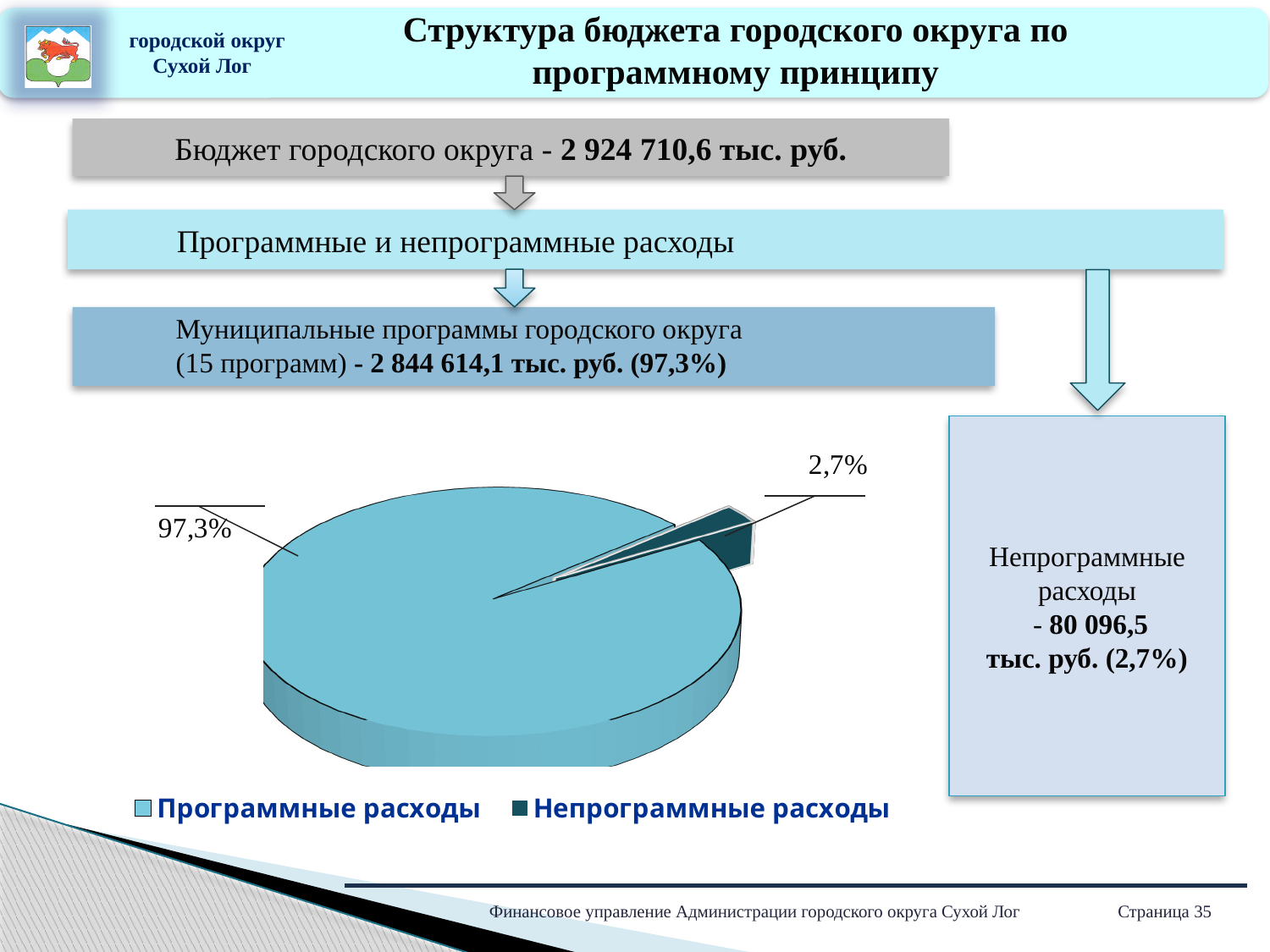
How many slices does the pie chart have? 2 How many entries does the legend of the pie chart list? 2 What share of the pie does Непрограммные расходы take? 2,7% Which slice of the pie chart is the smallest? Непрограммные расходы What kind of chart is shown on the slide? pie chart Which legend entry is shown in the dark teal colour? Непрограммные расходы What is the difference in percentage points between the Программные расходы and Непрограммные расходы slices? 94,6 Which legend entry is shown in the light blue colour? Программные расходы Which is larger in the pie chart: Программные расходы or Непрограммные расходы? Программные расходы Which slice of the pie chart is the largest? Программные расходы What is the total of the two slice percentages shown on the pie chart? 100% What share of the pie does Программные расходы take? 97,3%